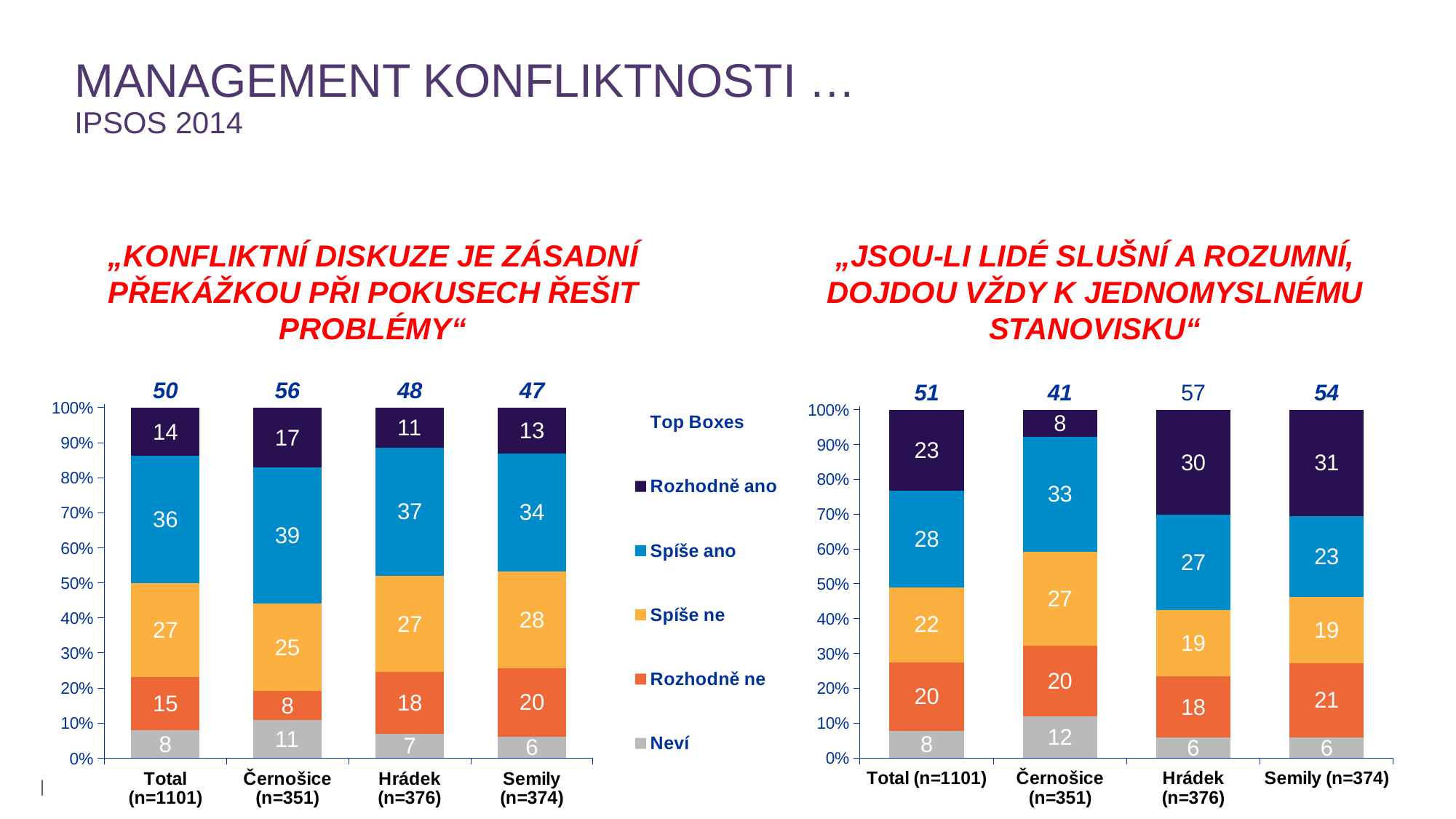
In the right chart ("Jsou-li lidé slušní a rozumní..."), what is the Rozhodně ano value for Semily (n=374)? 31 In the right chart, what is the Neví value for Černošice (n=351)? 12 In the right chart, which category has the lowest Top Boxes value? Černošice (n=351) In the right chart, what is the difference between the Rozhodně ano values for Hrádek (n=376) and Černošice (n=351)? 22 In the left chart ("Konfliktní diskuze je zásadní překážkou..."), what is the Spíše ano value for Černošice (n=351)? 39 In the left chart, which is larger: the Rozhodně ne value for Semily (n=374) or for Černošice (n=351)? Semily (n=374) In the left chart, which category has the highest Top Boxes value? Černošice (n=351) Which legend entry is shown in grey? Neví What type of chart is the right chart? Stacked bar chart How many categories are shown on the x axis of the left chart? 4 In the left chart, what is the Top Boxes value shown above the Hrádek (n=376) bar? 48